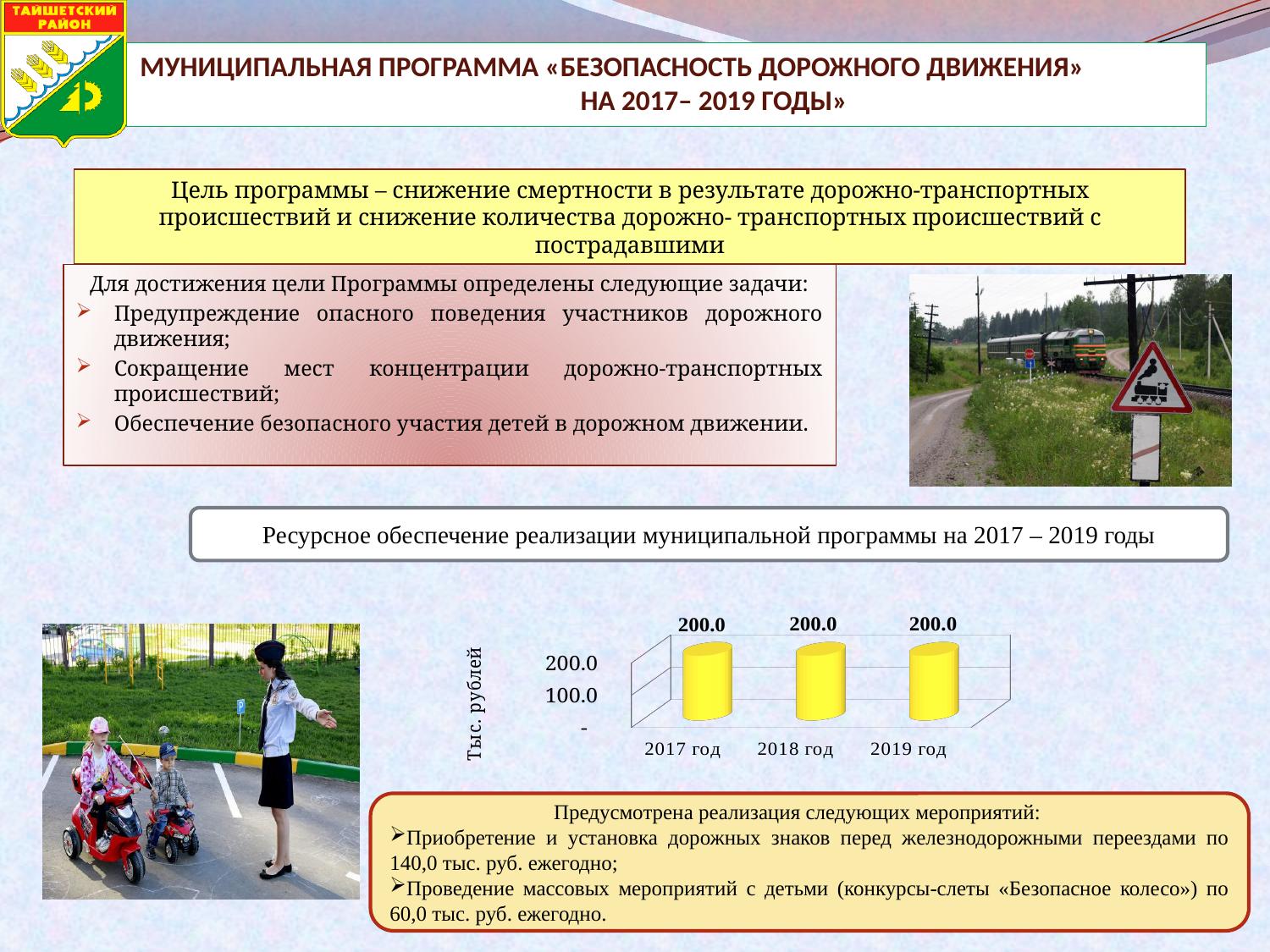
What is the value for 2019 год in the chart? 200.0 Do the values rise, fall or stay the same from 2017 год to 2019 год? Stay the same Is the value for 2019 год greater or less than 100.0? greater What is the value for 2017 год in the chart? 200.0 What is the value for 2018 год in the chart? 200.0 What is the label on the vertical axis of the chart? Тыс. рублей What is the difference between the values for 2019 год and 2017 год? 0.0 Is the value for 2018 год larger than, smaller than or equal to the value for 2017 год? Equal What colour are the bars in the chart? Yellow How many categories (years) are shown on the x axis of the chart? 3 What kind of chart is shown on the slide? Bar chart